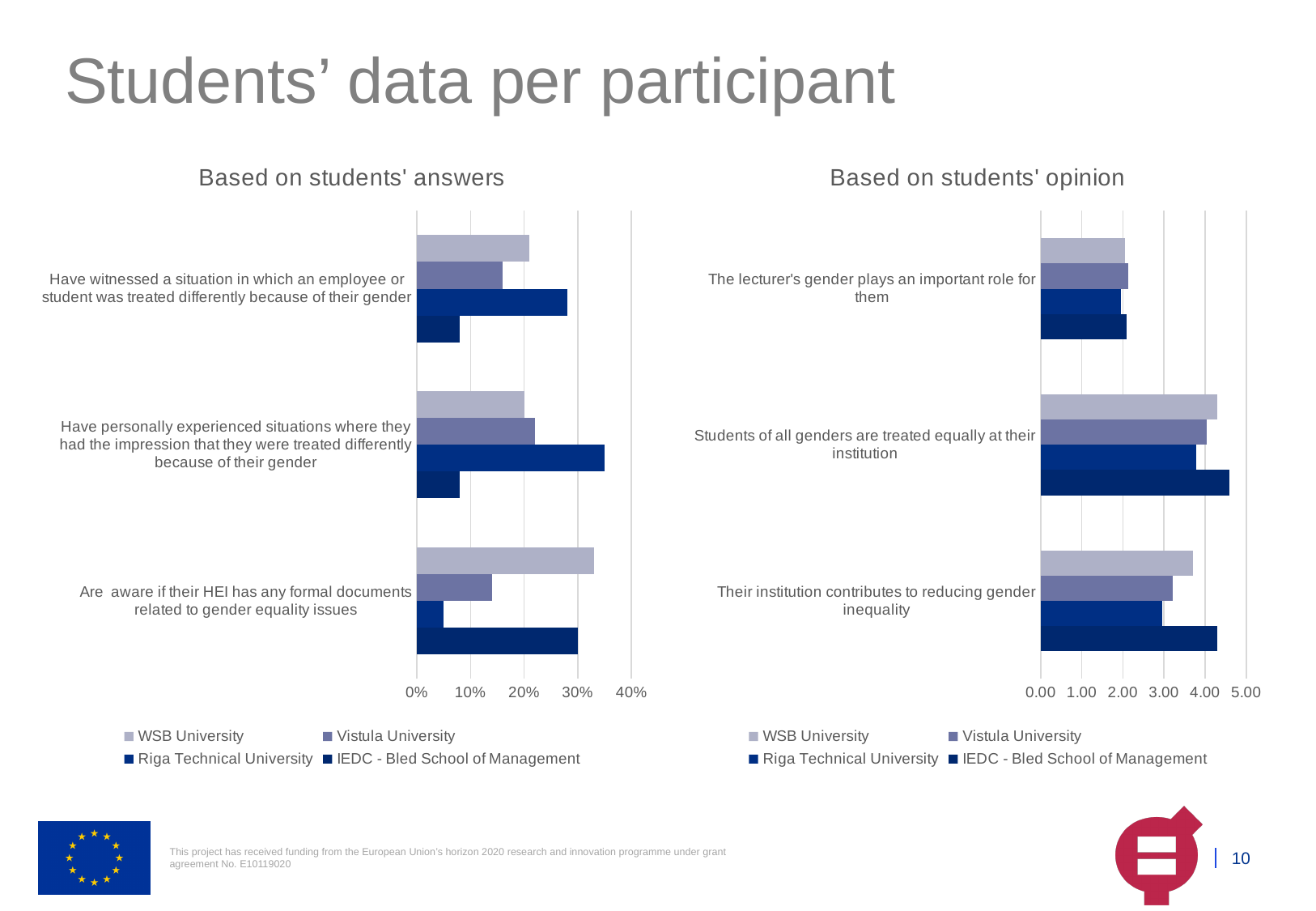
In the 'Based on students' answers' chart, which university has the highest value for 'Have personally experienced situations where they had the impression that they were treated differently because of their gender'? Riga Technical University How many categories are shown on the 'Based on students' answers' chart? 3 How many series does the legend of the 'Based on students' answers' chart list? 4 What kind of chart is the 'Based on students' answers' chart? bar chart In the 'Based on students' answers' chart, which university has the lowest value for 'Are aware if their HEI has any formal documents related to gender equality issues'? Riga Technical University In the 'Based on students' answers' chart, for 'Are aware if their HEI has any formal documents related to gender equality issues', which is larger: WSB University or Vistula University? WSB University In the 'Based on students' opinion' chart, is the value for IEDC - Bled School of Management for 'Students of all genders are treated equally at their institution' greater or less than 4.00? greater In the 'Based on students' answers' chart, is the value for Riga Technical University for 'Have personally experienced situations where they had the impression that they were treated differently because of their gender' greater or less than 30%? greater In the 'Based on students' opinion' chart, is the value for WSB University for 'Their institution contributes to reducing gender inequality' greater or less than 3.00? greater What is the title of the chart on the right side of the slide? Based on students' opinion In the 'Based on students' opinion' chart, which university has the highest value for 'Their institution contributes to reducing gender inequality'? IEDC - Bled School of Management